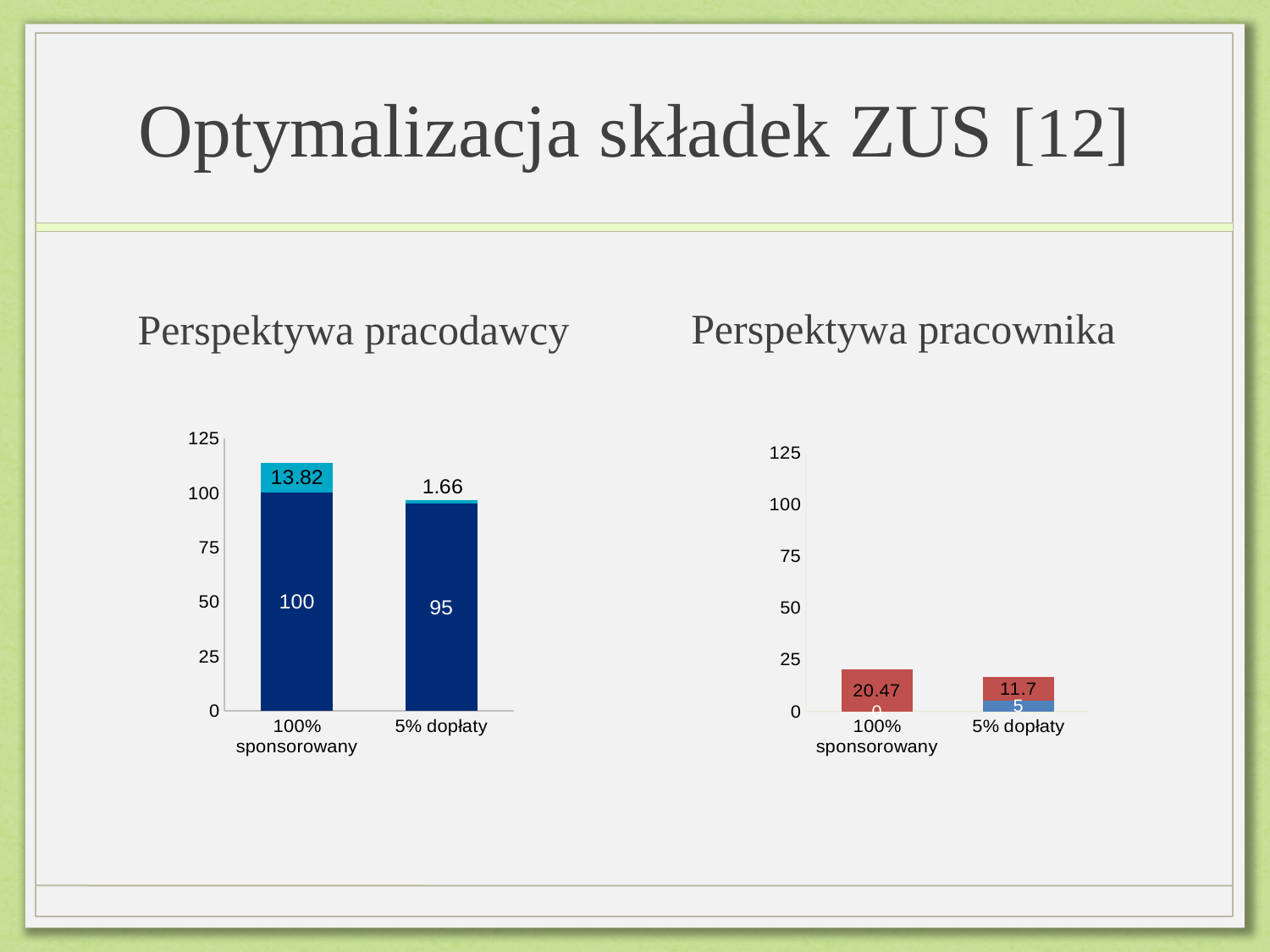
How many categories are shown on the x axis of the 'Perspektywa pracodawcy' chart? 2 In the 'Perspektywa pracownika' chart, what is the value of the top (red) segment for '100% sponsorowany'? 20.47 In the 'Perspektywa pracodawcy' chart, what is the difference between the bottom segment values for '100% sponsorowany' and '5% dopłaty'? 5 In the 'Perspektywa pracodawcy' chart, what is the total of the stacked bar for '100% sponsorowany'? 113.82 In the 'Perspektywa pracodawcy' chart, what is the value of the bottom (dark blue) segment for '100% sponsorowany'? 100 In the 'Perspektywa pracodawcy' chart, what is the total of the stacked bar for '5% dopłaty'? 96.66 In the 'Perspektywa pracownika' chart, what is the value of the bottom (blue) segment for '5% dopłaty'? 5 In the 'Perspektywa pracownika' chart, what is the total of the stacked bar for '5% dopłaty'? 16.7 What type of chart is the 'Perspektywa pracownika' chart? Stacked bar chart In the 'Perspektywa pracodawcy' chart, what is the value of the top (light blue) segment for '5% dopłaty'? 1.66 In the 'Perspektywa pracownika' chart, is the total bar for '100% sponsorowany' greater or less than 25? less In the 'Perspektywa pracownika' chart, which category has the higher total bar? 100% sponsorowany